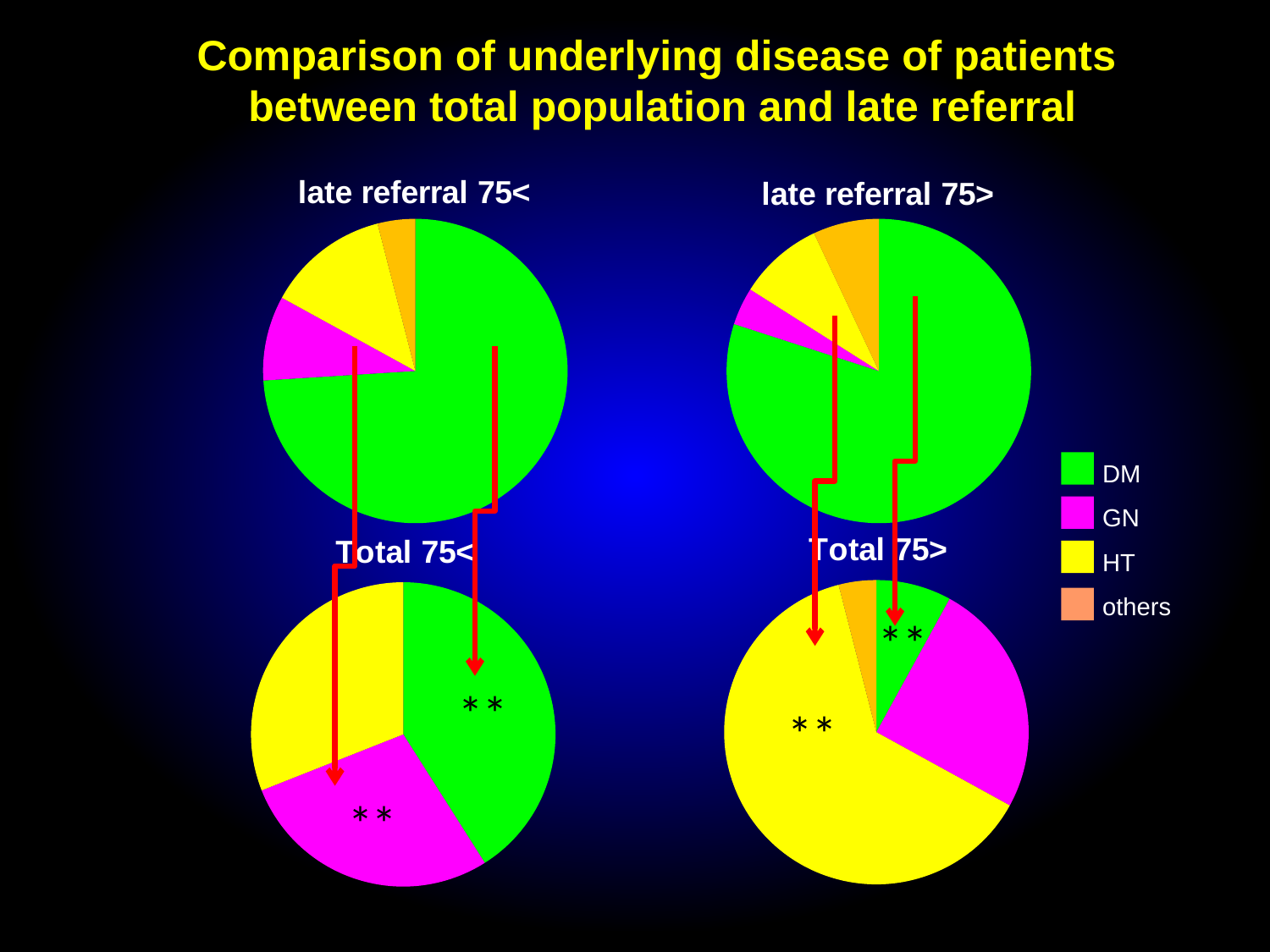
In the "Total 75>" pie chart, which slice is larger, GN or DM? GN How many categories does the legend list? 4 In the "Total 75<" pie chart, which category has the largest slice? DM In the "late referral 75>" pie chart, which category has the largest slice? DM In the "Total 75>" pie chart, which category has the largest slice? HT In the "late referral 75<" pie chart, which category has the smallest slice? others Which pie chart has the larger DM share, "late referral 75<" or "Total 75<"? late referral 75< Which colour represents HT in the legend? yellow What kind of chart is used for "late referral 75<"? pie chart In the "Total 75>" pie chart, which category has the smallest slice? others How many pie charts are shown on the slide? 4